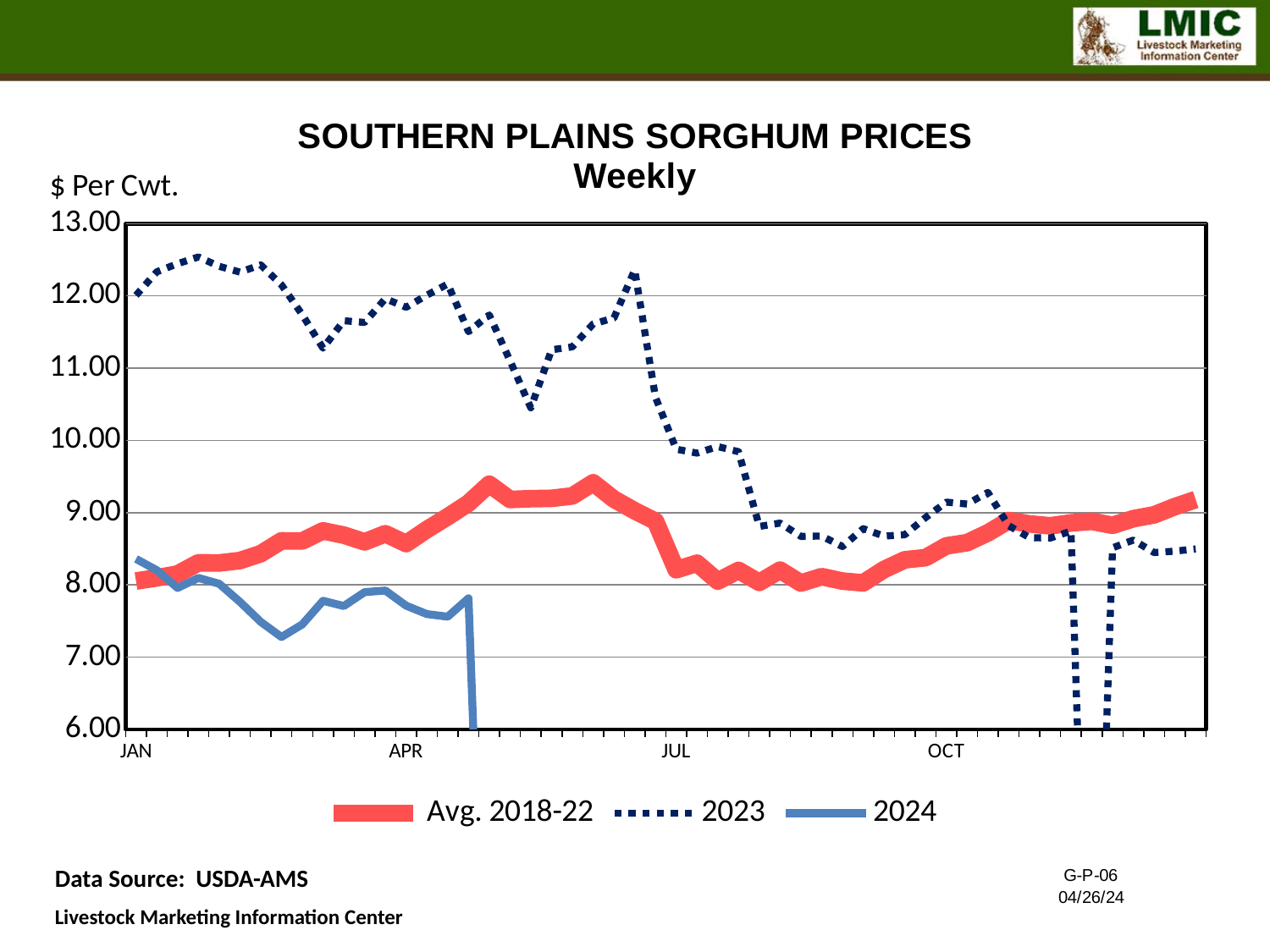
How many series does the legend list? 3 Is the 2023 value in early February greater or less than 12.00? greater Is the 2024 value in mid-March greater or less than 8.00? less What kind of chart is shown on the slide? line chart What is the title of the chart? SOUTHERN PLAINS SORGHUM PRICES Weekly Does the 2023 series overall rise or fall from JAN to the end of the year? fall Which series reaches the highest value on the chart? 2023 Around APR, which series is higher, Avg. 2018-22 or 2024? Avg. 2018-22 What unit is shown on the vertical axis label? $ Per Cwt. In JAN, which series is higher, 2023 or 2024? 2023 Is the 2023 value in mid-May greater or less than 10.00? greater